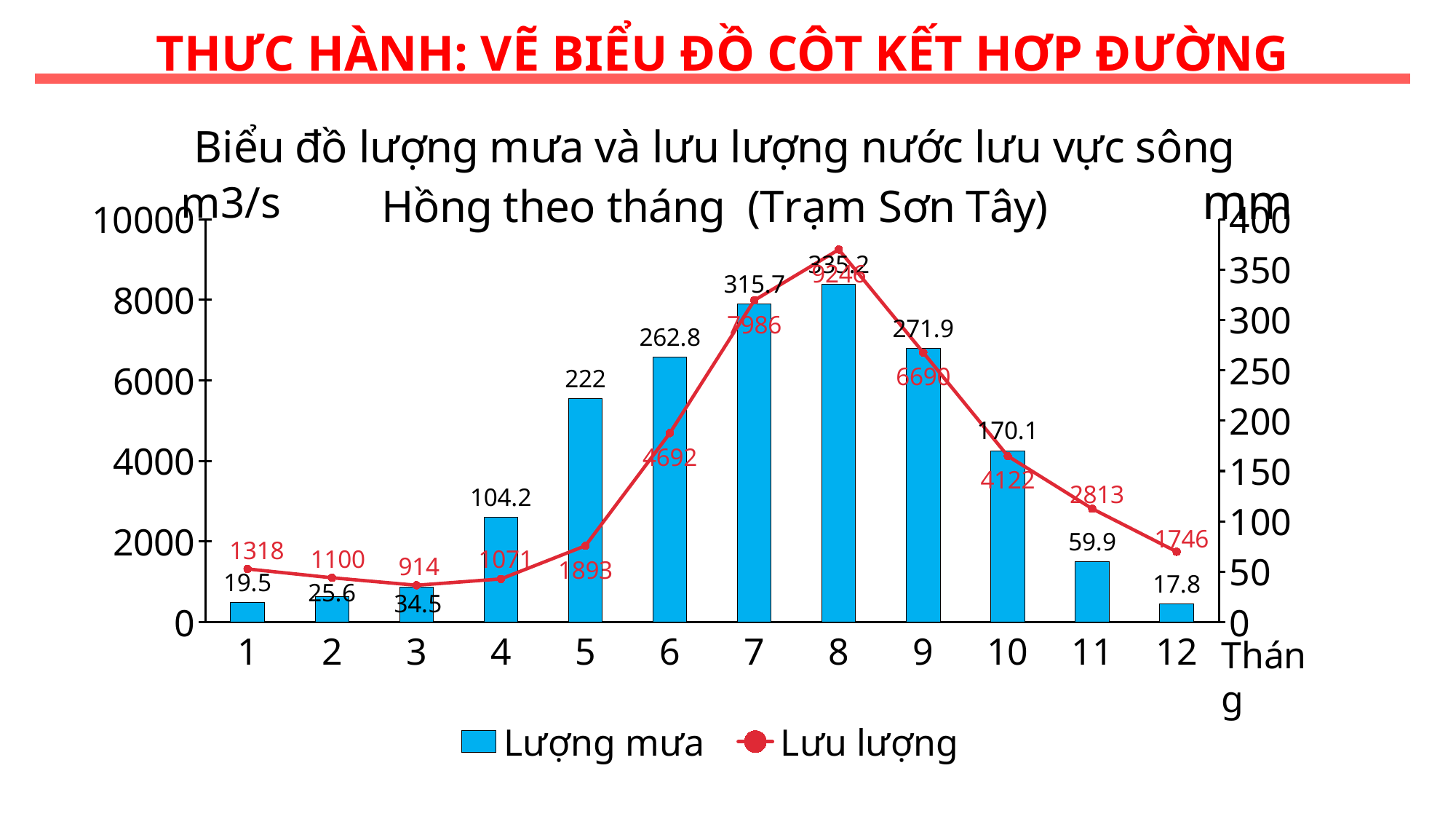
What kind of chart is this? Combined bar and line chart What is the Lưu lượng value for month 6? 4692 Which is larger, the Lượng mưa value for month 5 or for month 10? month 5 What is the Lượng mưa value for month 4? 104.2 How many months are shown on the x axis? 12 Which month has the lowest Lưu lượng value? 3 What is the Lưu lượng value for month 11? 2813 Which month has the highest Lượng mưa value? 8 How many series does the legend list? 2 What is the difference between the Lưu lượng values for month 7 and month 9? 1296 What is the Lượng mưa value for month 7? 315.7 Which month has the lowest Lượng mưa value? 12